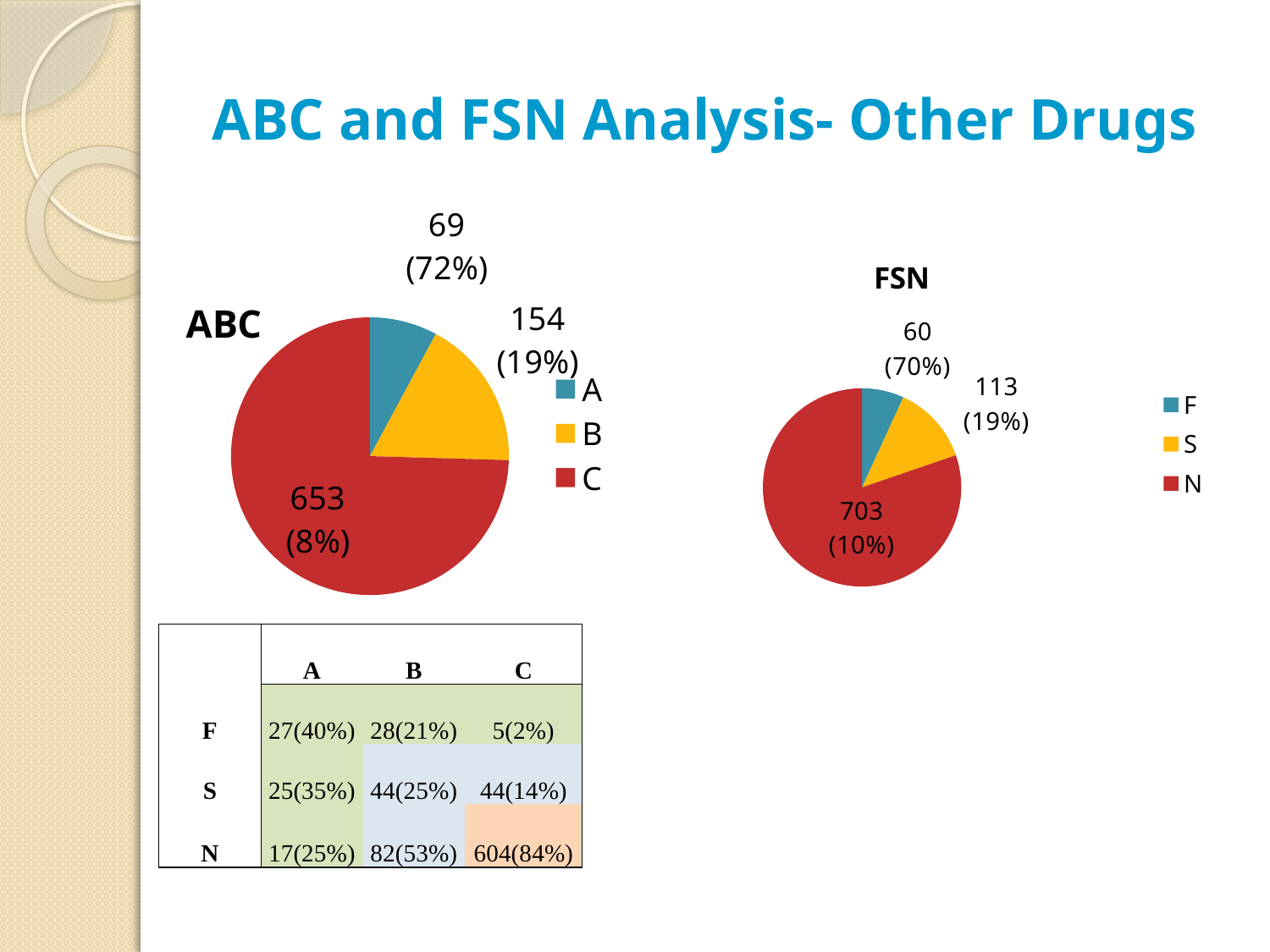
In the FSN chart, which count is larger, S or N? N In the FSN chart, what count is shown for category N? 703 In the FSN chart, which category has the smallest count? F In the ABC chart, what is the difference between the counts for C and B? 499 What type of chart is the ABC chart? pie chart In the ABC chart, which category has the largest count? C In the ABC chart, which category has the smallest count? A In the FSN chart, what percentage is printed next to category S? 19% How many entries does the legend of the FSN chart list? 3 In the ABC chart, what percentage is printed next to category A? 72% In the ABC chart, what count is shown for category B? 154 In the ABC chart, what count is shown for category C? 653